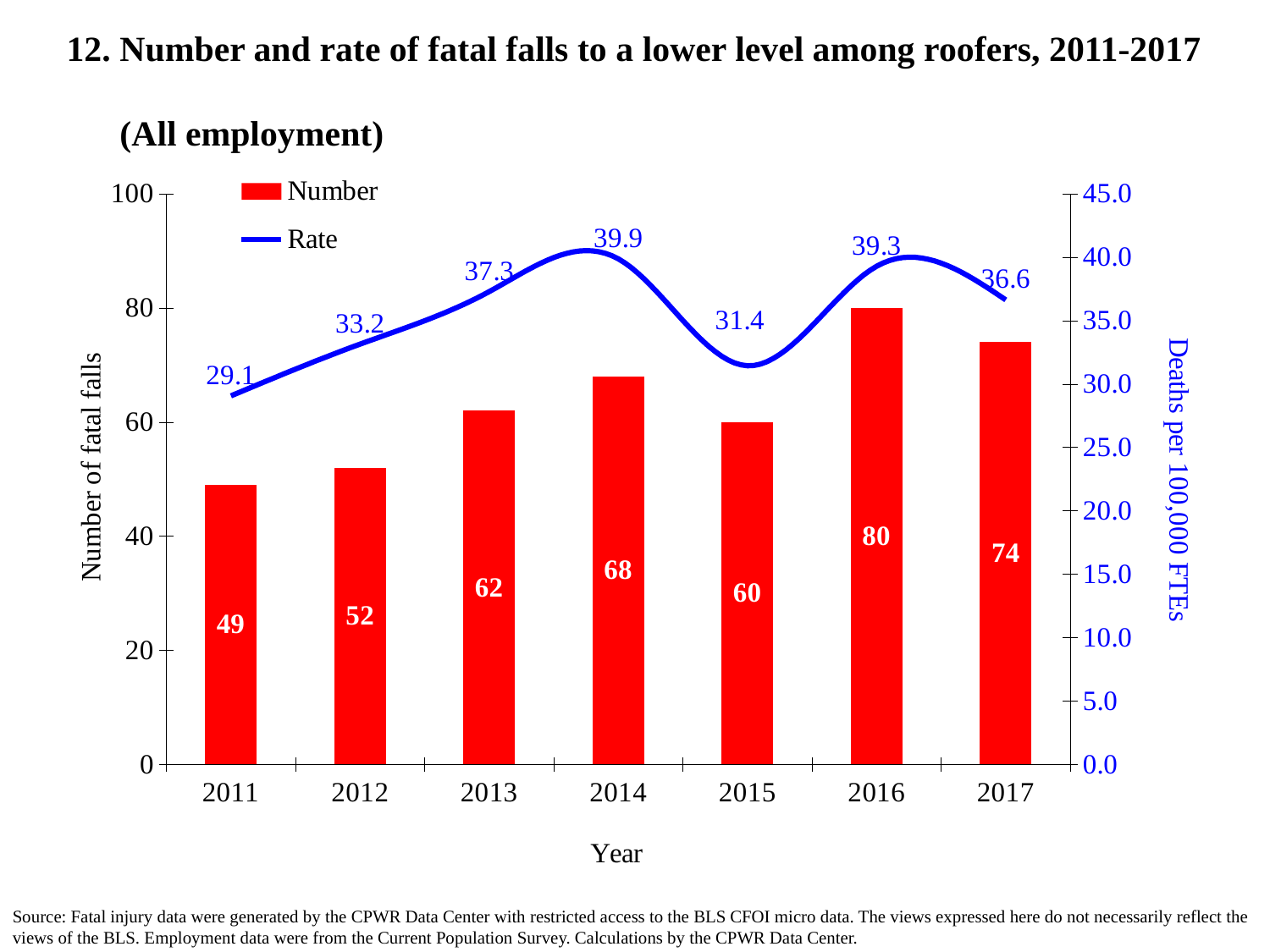
Which year had the lowest rate of fatal falls? 2011 How many series does the legend list? 2 What kind of chart is used to show the Number series? bar chart Which year had more fatal falls, 2013 or 2015? 2013 What was the rate of fatal falls in 2011? 29.1 What is the label of the right-hand vertical axis? Deaths per 100,000 FTEs What was the number of fatal falls among roofers in 2016? 80 What is the difference in the number of fatal falls between 2016 and 2011? 31 Which year had the highest number of fatal falls? 2016 What was the rate of fatal falls (deaths per 100,000 FTEs) in 2014? 39.9 How many years are shown on the x axis? 7 Was the rate of fatal falls in 2015 greater or less than 35.0? less